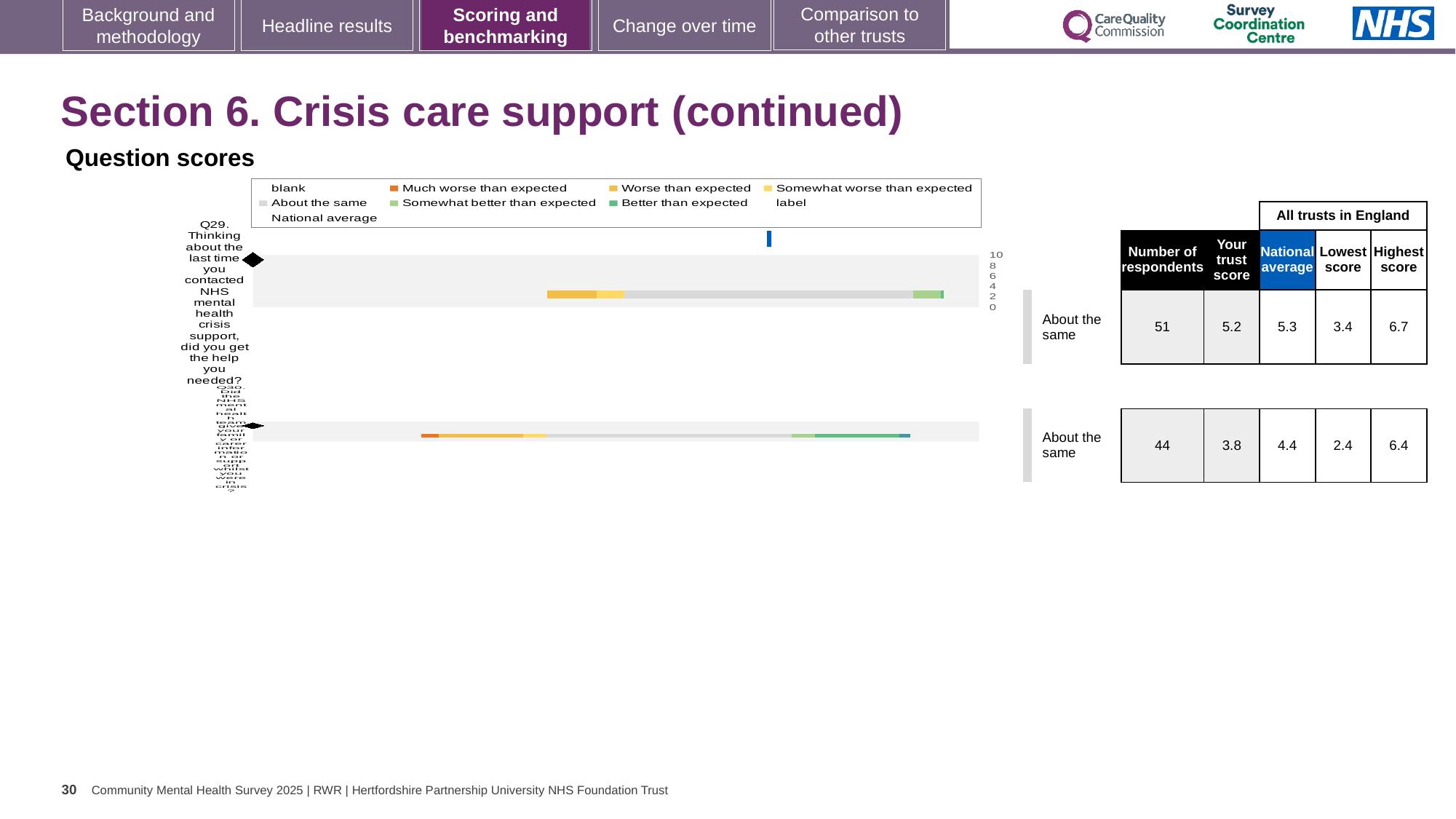
What kind of chart is shown under 'Question scores'? bar chart What is the difference between the highest and lowest scores for Q29? 3.3 How many questions (bars) are plotted in the Question scores chart? 2 How many respondents answered Q30? 44 What is the lowest score among all trusts in England for Q30? 2.4 For Q30, which is larger: the trust score or the national average? national average What is the national average for Q29? 5.3 How many entries does the legend of the Question scores chart list? 9 What is the trust score for Q30? 3.8 What benchmark category is shown for Q29 and Q30? About the same What is the highest score among all trusts in England for Q29? 6.7 What is the trust score for Q29 (did you get the help you needed)? 5.2